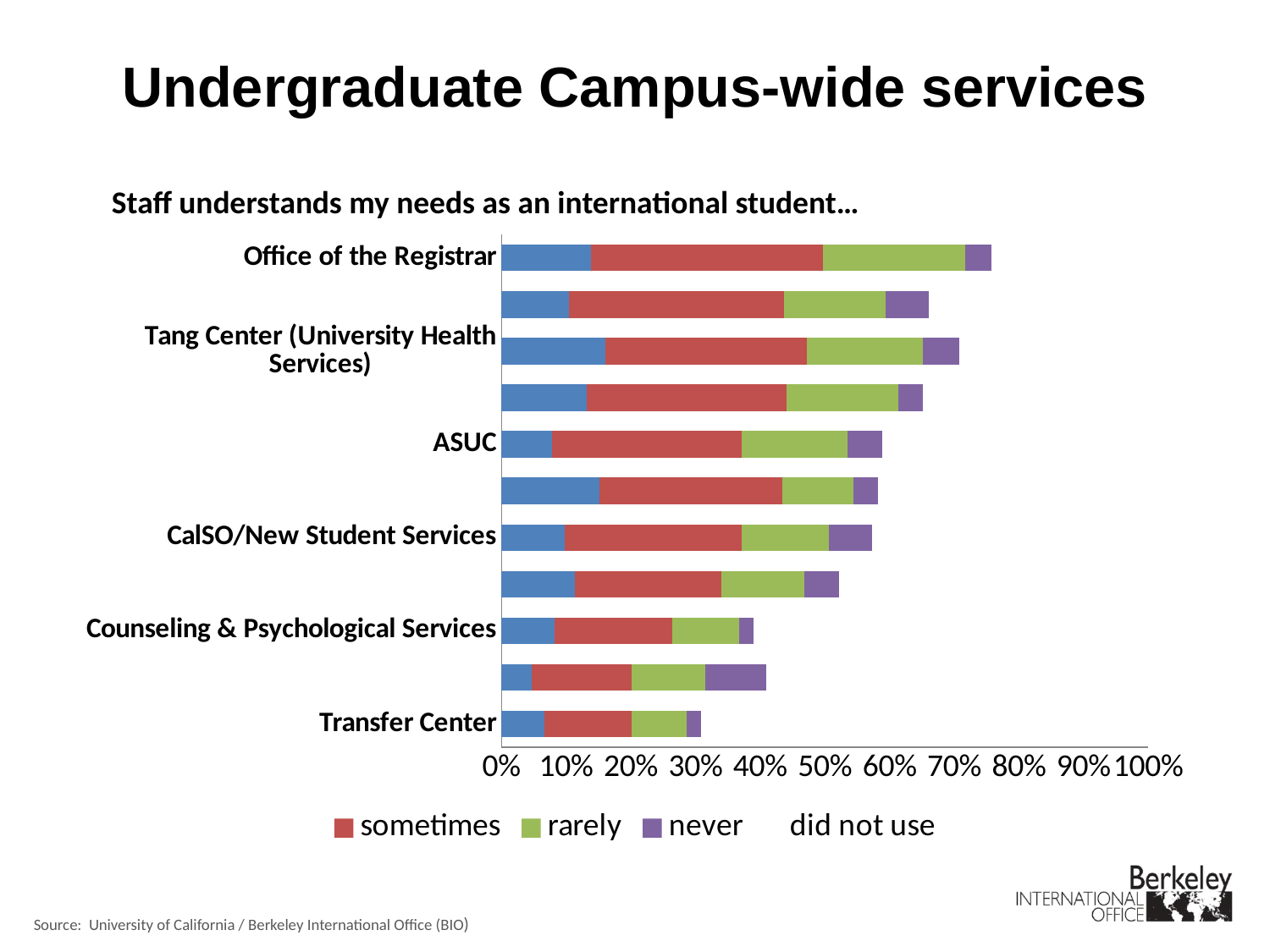
Which labeled category has the longest total bar? Office of the Registrar What statement is the chart measuring responses to? Staff understands my needs as an international student… How many entries does the chart legend list? 4 Which has a longer total bar, Office of the Registrar or Transfer Center? Office of the Registrar Which labeled category has the shortest total bar? Transfer Center Is the total bar length for Counseling & Psychological Services greater or less than 50%? less Is the total bar length for CalSO/New Student Services greater or less than 50%? greater Is the total bar length for Transfer Center greater or less than 40%? less What kind of chart is shown on the slide? Stacked bar chart How many bars are plotted in the chart? 11 What colour represents the "sometimes" series in the legend? Red